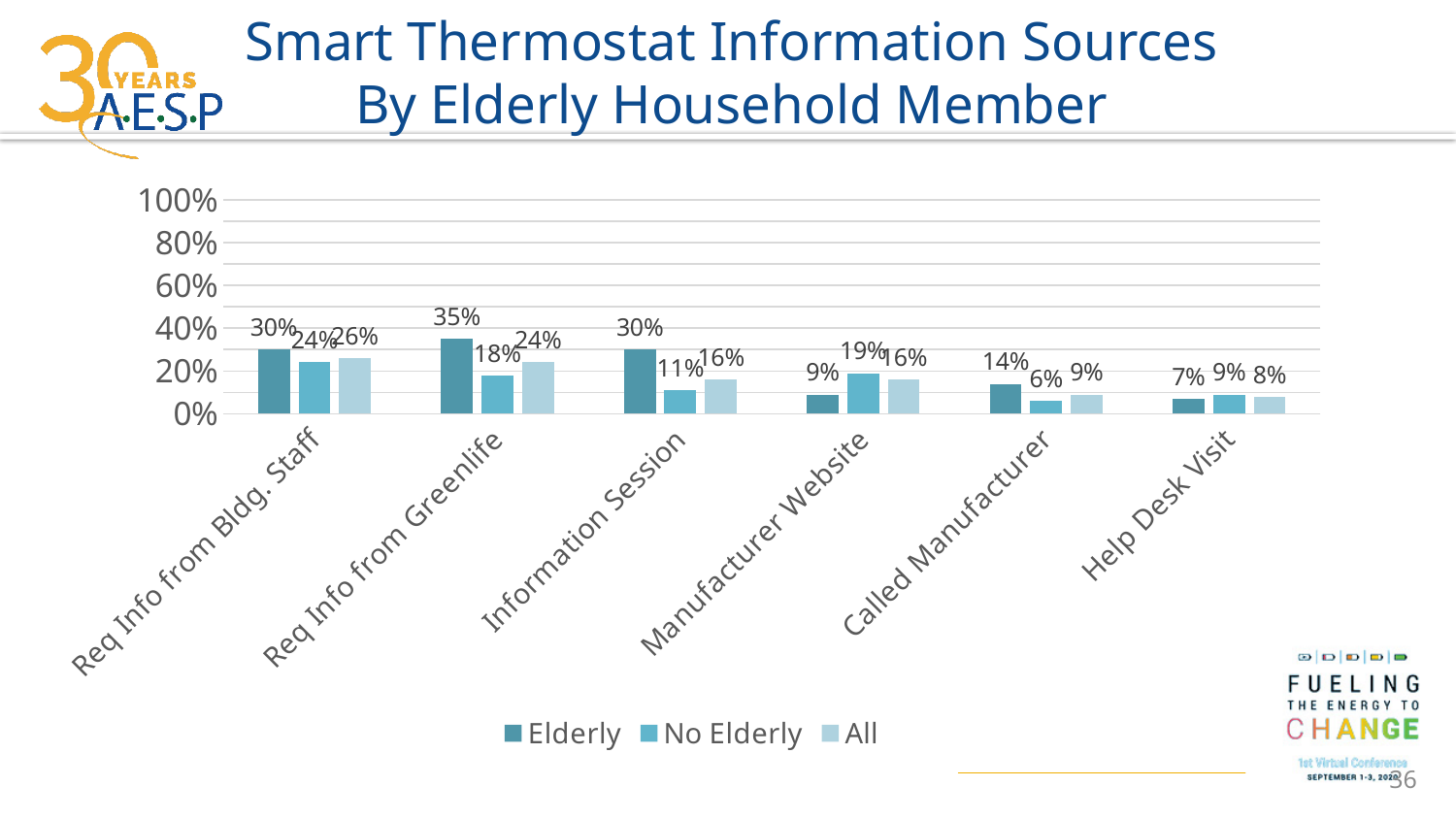
What is the difference between the Elderly and No Elderly values for Req Info from Greenlife? 17% What kind of chart is shown on the slide? Bar chart What is the title of the chart on the slide? Smart Thermostat Information Sources By Elderly Household Member What is the No Elderly value for Information Session? 11% What is the Elderly value for Req Info from Greenlife? 35% Which category has the highest Elderly value? Req Info from Greenlife How many categories are shown on the x axis? 6 What is the All value for Called Manufacturer? 9% Which category has the lowest No Elderly value? Called Manufacturer What is the No Elderly value for Manufacturer Website? 19% How many series does the legend list? 3 For Manufacturer Website, which is larger: the Elderly value or the No Elderly value? No Elderly